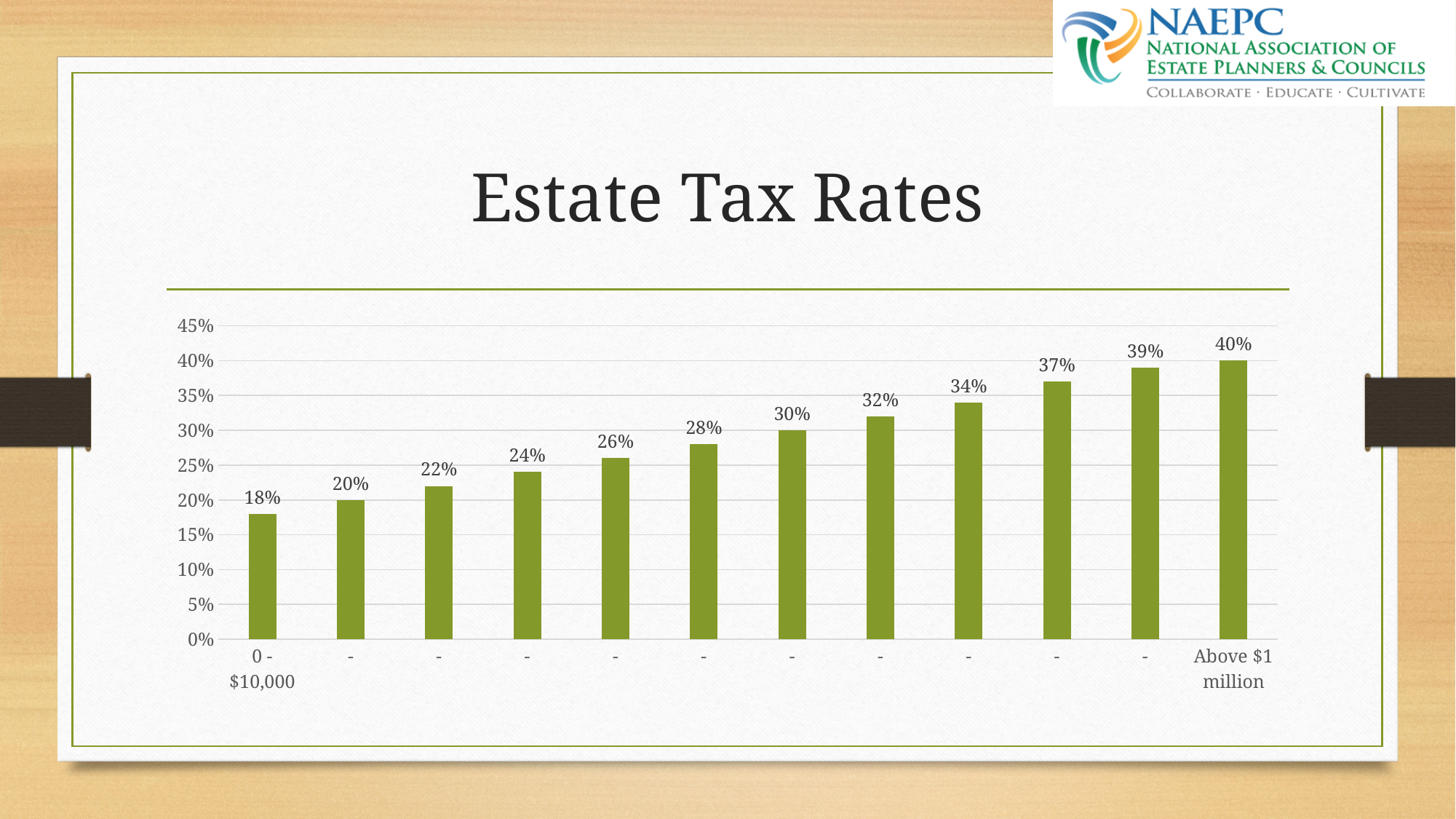
What is the estate tax rate for the "Above $1 million" category? 40% What kind of chart is shown on the slide? Bar chart How many bars are plotted in the chart? 12 Which is larger, the rate for "0 - $10,000" or the rate for "Above $1 million"? Above $1 million What is the difference between the rate for "Above $1 million" and the rate for "0 - $10,000"? 22% What value is shown on the second bar from the right? 39% What is the title of the slide containing the chart? Estate Tax Rates Do the estate tax rates rise or fall from left to right across the chart? Rise Which category has the lowest estate tax rate? 0 - $10,000 Which category has the highest estate tax rate? Above $1 million What is the estate tax rate for the "0 - $10,000" category? 18% What value is shown on the sixth bar from the left? 28%